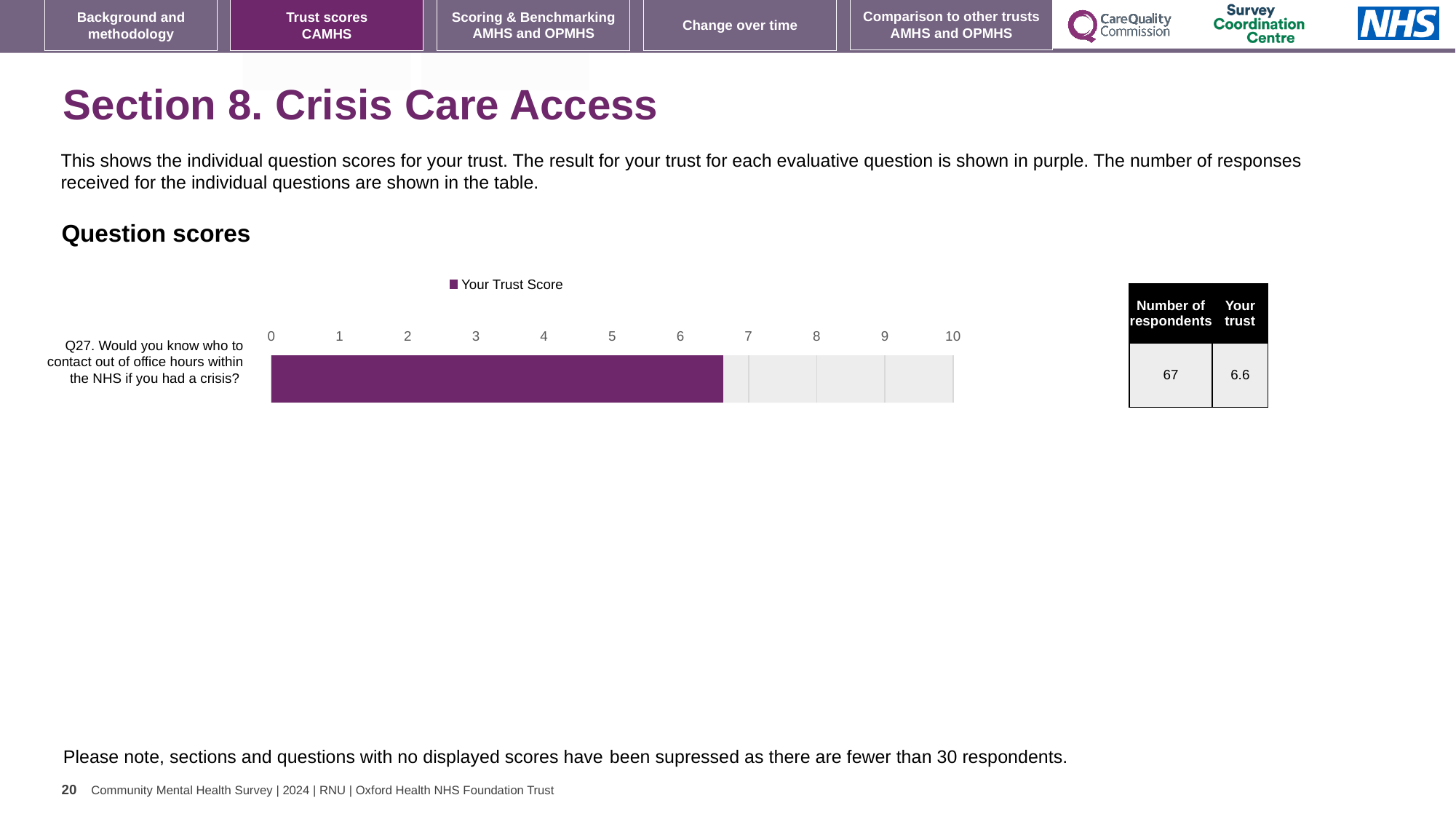
Is the Your Trust Score for Q27 greater or less than 5? greater How many respondents answered Q27 according to the table next to the chart? 67 How many questions are plotted in the Question scores chart? 1 What is the maximum value shown on the x axis of the Question scores chart? 10 What is the Your Trust Score for Q27 (Would you know who to contact out of office hours within the NHS if you had a crisis?)? 6.6 Is the Your Trust Score for Q27 greater or less than 8? less What is the name of the series shown in the legend of the Question scores chart? Your Trust Score How many series does the legend of the Question scores chart list? 1 What kind of chart is used to show the question scores? Bar chart